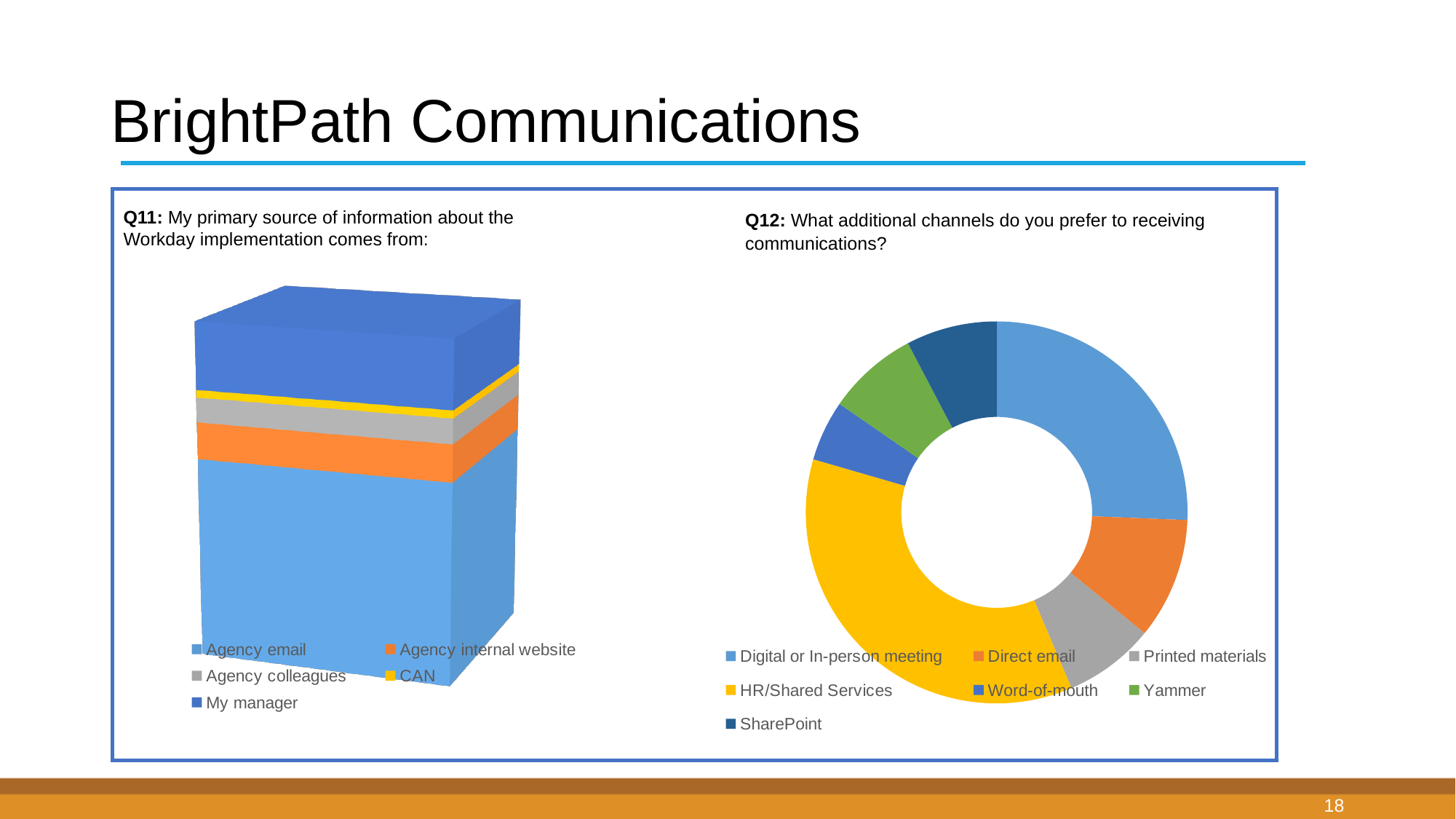
In the Q12 chart, which slice is larger: Digital or In-person meeting or Direct email? Digital or In-person meeting In the Q11 chart, which segment is larger: My manager or Agency internal website? My manager In the Q11 chart, how many series does the legend list? 5 In the Q11 chart, which source makes up the largest segment of the stacked bar? Agency email In the Q12 chart, how many channels are shown as slices? 7 What kind of chart is the Q12 chart on the right of the slide? Doughnut chart What question does the Q12 chart on the right of the slide illustrate? What additional channels do you prefer to receiving communications? What kind of chart is the Q11 chart on the left of the slide? Stacked bar chart In the Q11 chart, which segment is larger: Agency colleagues or CAN? Agency colleagues In the Q12 chart, which colour represents SharePoint in the legend? Dark blue In the Q12 chart, which channel has the largest slice? HR/Shared Services In the Q11 chart, which source makes up the smallest segment of the stacked bar? CAN